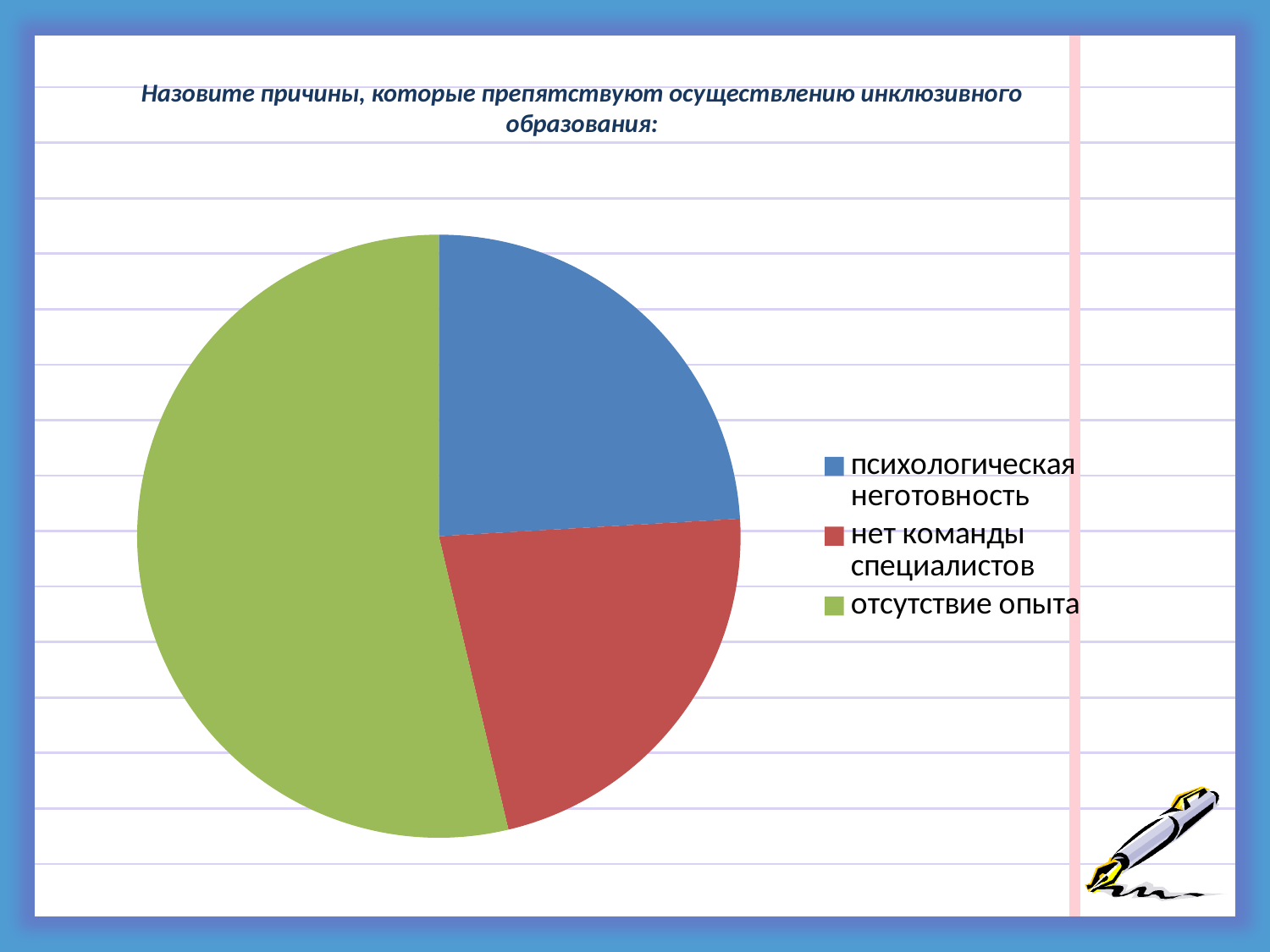
What type of chart is shown on the slide? pie chart Which slice is larger: отсутствие опыта or психологическая неготовность? отсутствие опыта How many entries does the legend of the pie chart list? 3 Which slice is larger: отсутствие опыта or нет команды специалистов? отсутствие опыта How many slices does the pie chart have? 3 Which category has the largest slice of the pie chart? отсутствие опыта What is the title of the chart on the slide? Назовите причины, которые препятствуют осуществлению инклюзивного образования: Which colour represents нет команды специалистов in the pie chart? red